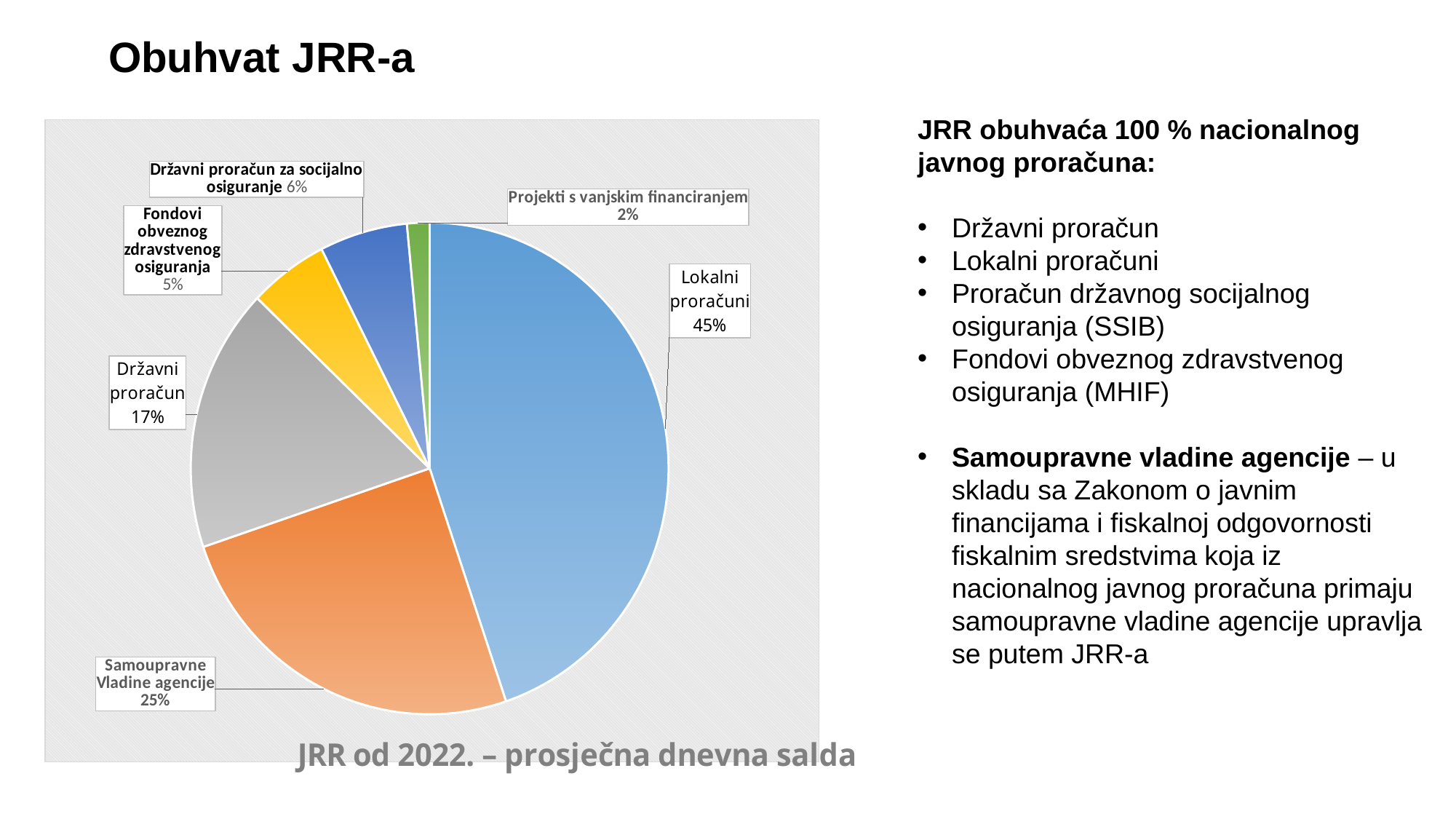
Which category has the smallest slice of the pie? Projekti s vanjskim financiranjem Which is larger, Državni proračun or Državni proračun za socijalno osiguranje? Državni proračun What is the value shown for Fondovi obveznog zdravstvenog osiguranja? 5% What is the value shown for Državni proračun? 17% What kind of chart is shown on the slide? Pie chart What is the difference in percentage points between Lokalni proračuni and Samoupravne Vladine agencije? 20 What is the caption shown below the pie chart? JRR od 2022. – prosječna dnevna salda What is the value shown for Državni proračun za socijalno osiguranje? 6% What is the value shown for Samoupravne Vladine agencije? 25% What share of the pie does Lokalni proračuni hold? 45% How many slices does the pie chart have? 6 Which category has the largest slice of the pie? Lokalni proračuni